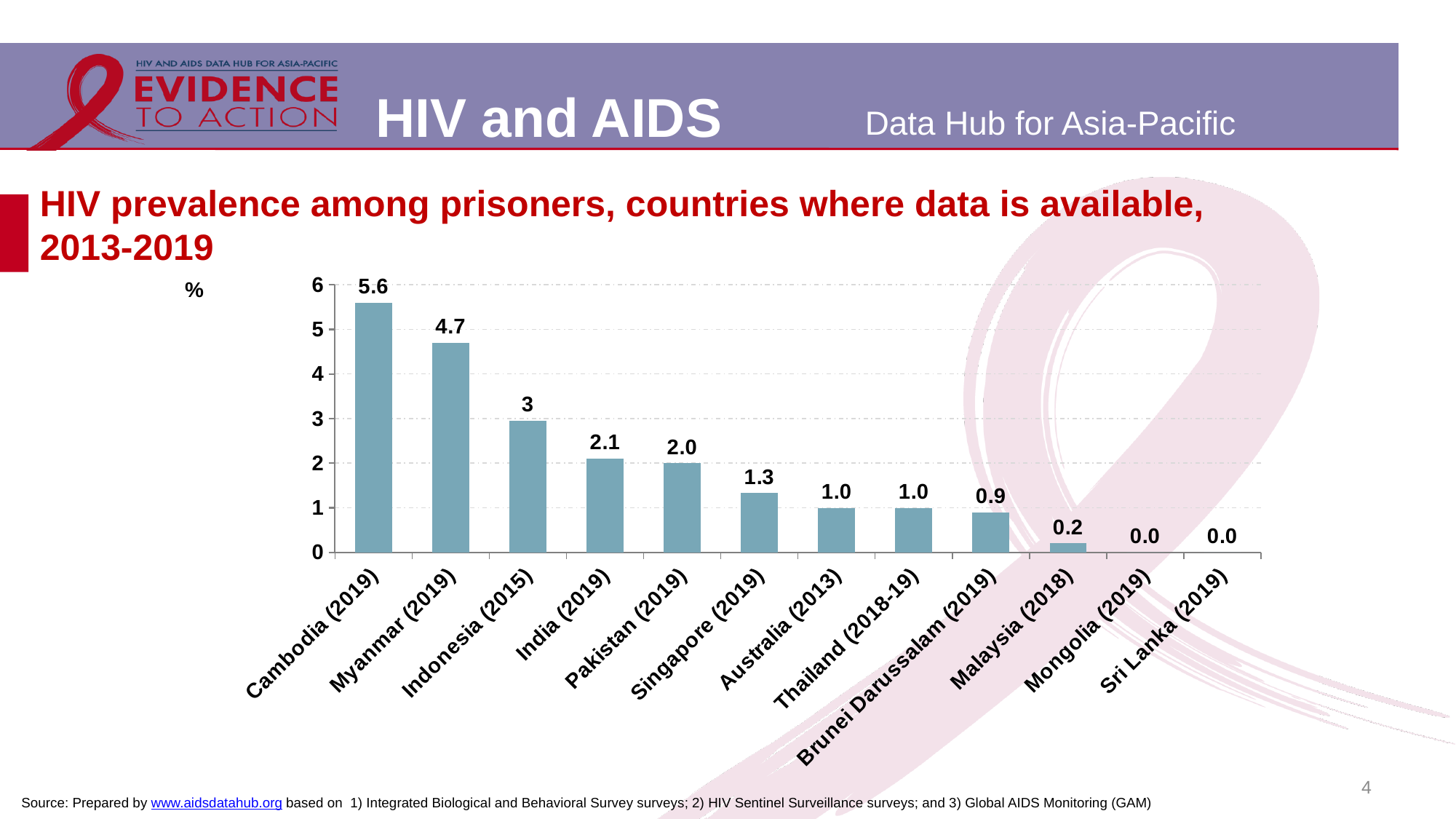
What is the difference between the values for Indonesia (2015) and Brunei Darussalam (2019)? 2.1 What is the HIV prevalence among prisoners for Indonesia (2015)? 3 Which country has the highest HIV prevalence among prisoners? Cambodia (2019) How many countries are shown in the chart? 12 Do the values rise or fall from left to right across the chart? fall What is the HIV prevalence among prisoners for Cambodia (2019)? 5.6 What kind of chart is shown on the slide? bar chart Which has a higher value, India (2019) or Singapore (2019)? India (2019) What is the HIV prevalence among prisoners for Malaysia (2018)? 0.2 What is the difference between the values for Cambodia (2019) and Myanmar (2019)? 0.9 What unit is shown on the y axis of the chart? % Is the value for Pakistan (2019) greater or less than 3? less